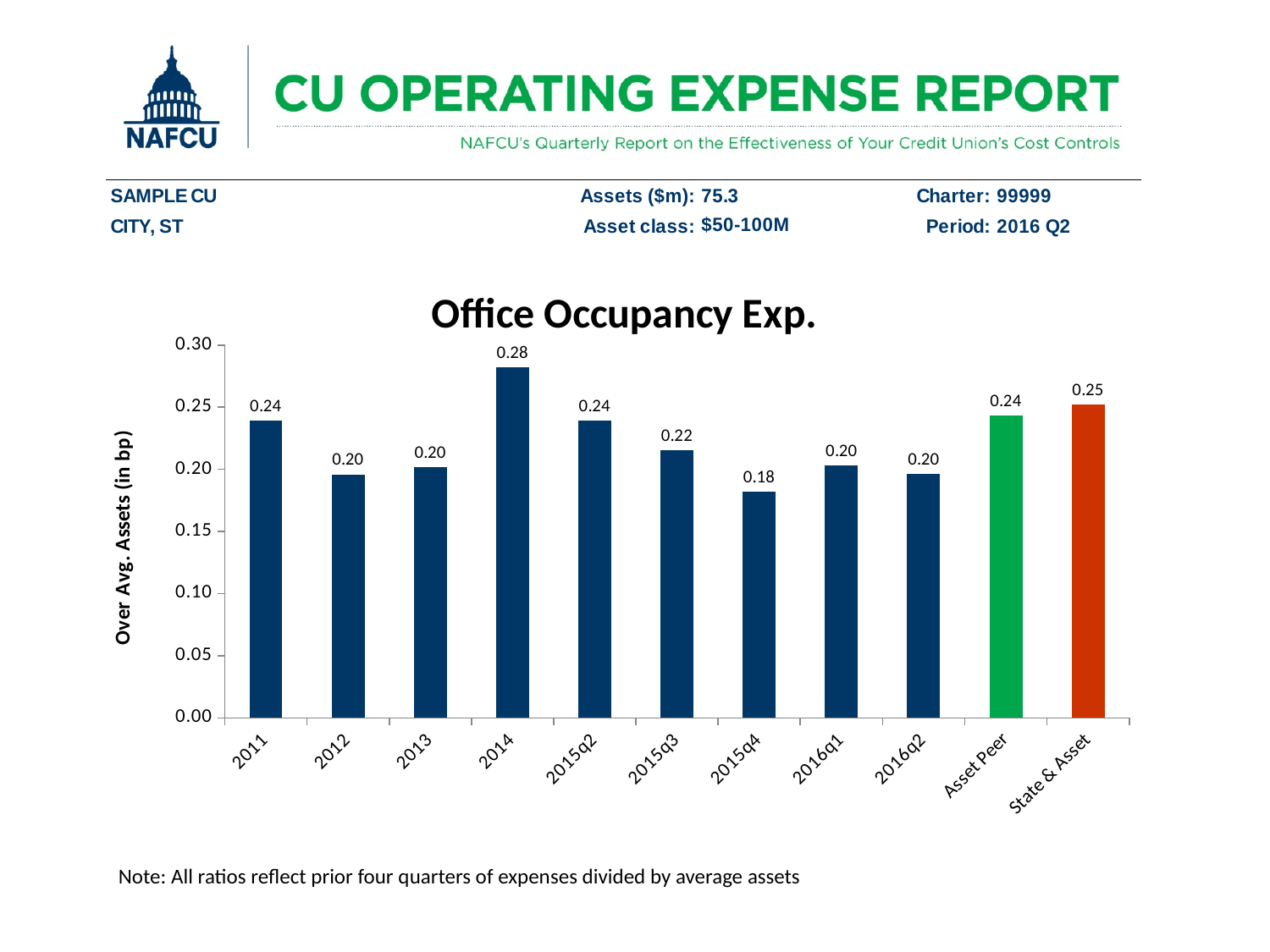
What is the difference between the values for 2014 and 2015q4 in the Office Occupancy Exp. chart? 0.10 Which category has the highest value in the Office Occupancy Exp. chart? 2014 How many categories are shown on the x axis of the Office Occupancy Exp. chart? 11 Which is larger in the Office Occupancy Exp. chart, the value for 2014 or the value for 2015q2? 2014 What is the y-axis title of the Office Occupancy Exp. chart? Over Avg. Assets (in bp) What is the value for 2014 in the Office Occupancy Exp. chart? 0.28 What kind of chart is the Office Occupancy Exp. chart? bar chart Do the values in the Office Occupancy Exp. chart rise or fall from 2015q2 to 2015q4? fall Is the value for 2014 in the Office Occupancy Exp. chart greater or less than 0.25? greater What is the value for 2015q4 in the Office Occupancy Exp. chart? 0.18 What is the value for State & Asset in the Office Occupancy Exp. chart? 0.25 Which category has the lowest value in the Office Occupancy Exp. chart? 2015q4